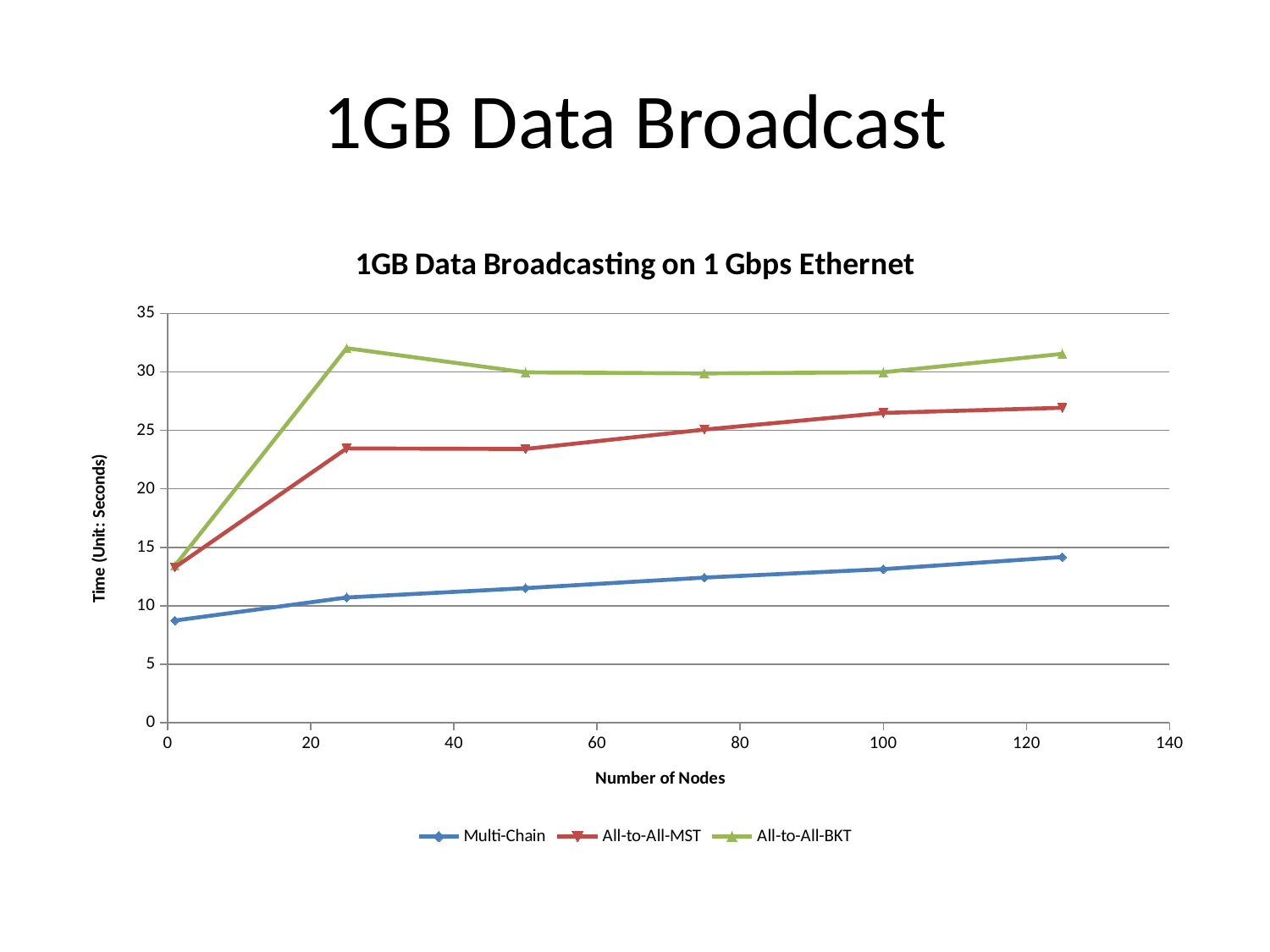
What is the label of the x axis? Number of Nodes At 50 nodes, which is larger: the time for All-to-All-MST or the time for Multi-Chain? All-to-All-MST How many data points are plotted for the Multi-Chain series? 6 How many series does the legend list? 3 Which series has the lowest time at 125 nodes? Multi-Chain Which series has the highest time at 100 nodes? All-to-All-BKT Does the Multi-Chain series rise or fall as the number of nodes increases? rise Is the value for All-to-All-BKT at 25 nodes greater or less than 30? greater What is the title of the chart? 1GB Data Broadcasting on 1 Gbps Ethernet What kind of chart is shown on the slide? line chart Is the value for Multi-Chain at 125 nodes greater or less than 15? less Is the value for All-to-All-MST at 100 nodes greater or less than 25? greater